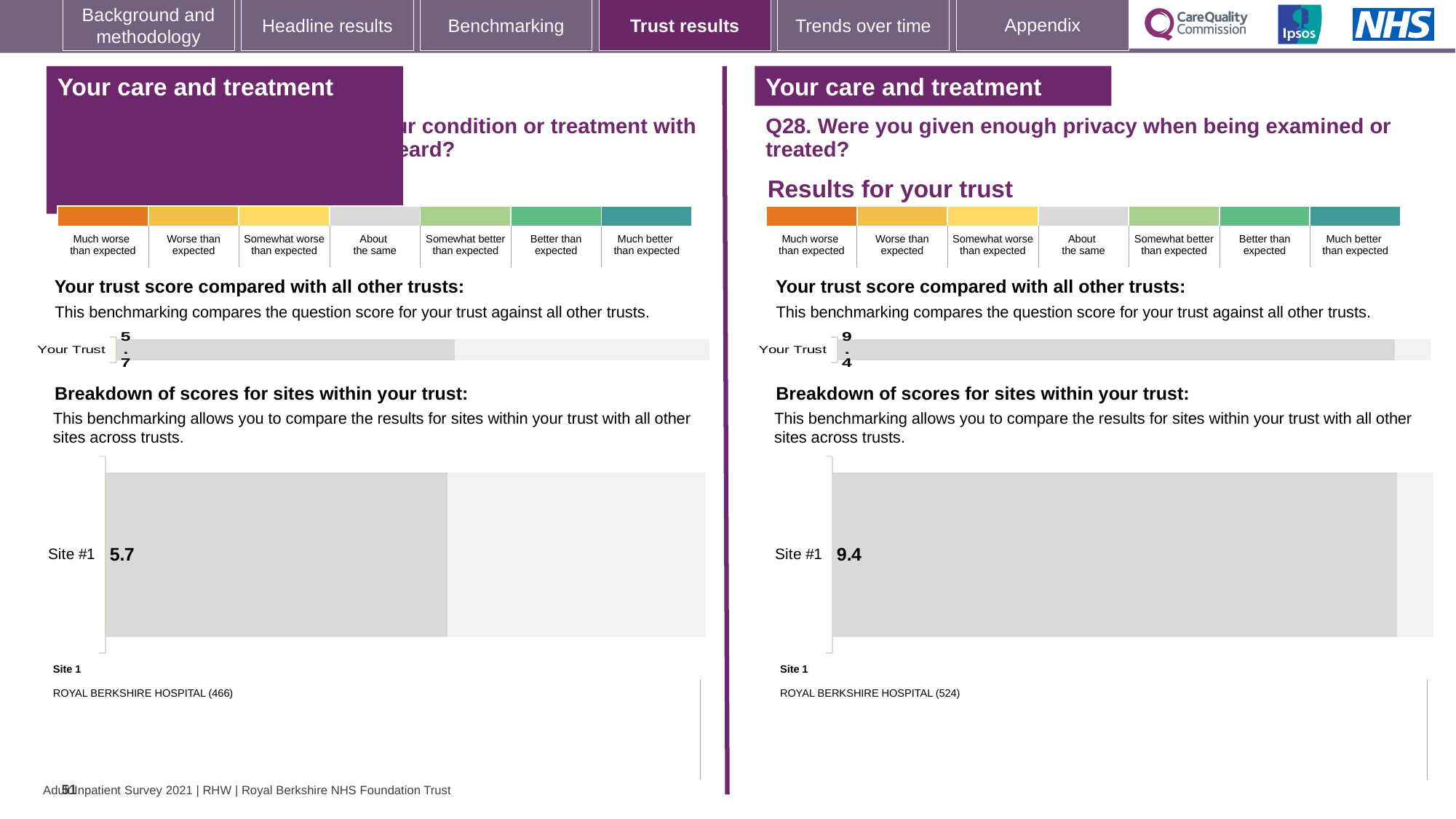
What is the difference between the Site #1 score on the right-hand Q28 chart and the Site #1 score on the left-hand chart? 3.7 On the left-hand side of the slide, what is the score shown for Your Trust in the trust comparison chart? 5.7 In the right-hand 'Breakdown of scores for sites within your trust' chart for Q28, what is the value for Site #1? 9.4 Which hospital is listed as Site 1 on the left-hand side of the slide? ROYAL BERKSHIRE HOSPITAL (466) Which hospital is listed as Site 1 on the right-hand side of the slide? ROYAL BERKSHIRE HOSPITAL (524) How many sites are shown in the left-hand 'Breakdown of scores for sites within your trust' chart? 1 In the left-hand 'Breakdown of scores for sites within your trust' chart, what is the value for Site #1? 5.7 How many sites are shown in the right-hand 'Breakdown of scores for sites within your trust' chart? 1 What type of chart is used to show the Site #1 score on the right-hand side of the slide? Bar chart Which is larger: the Site #1 score on the left-hand chart or the Site #1 score on the right-hand Q28 chart? The right-hand Q28 chart On the right-hand chart for Q28 (privacy when being examined or treated), what is the score shown for Your Trust? 9.4